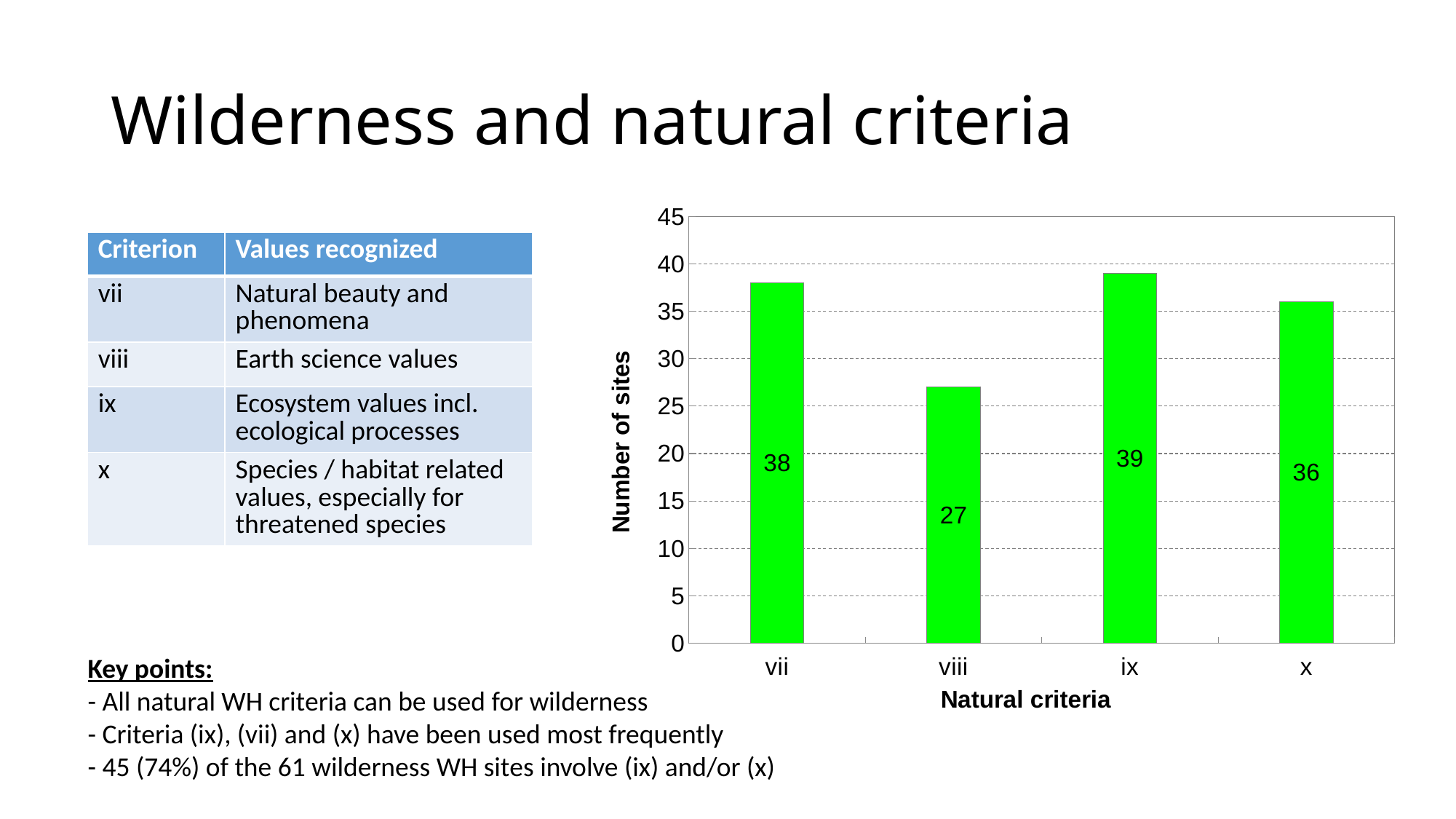
What type of chart is shown on the slide? bar chart How many natural criteria are shown on the x axis of the chart? 4 What is the difference in number of sites between criterion ix and criterion viii? 12 What is the number of sites for criterion ix? 39 Which natural criterion has the lowest number of sites? viii Is the number of sites for criterion viii greater or less than 30? less What is the label of the vertical axis of the chart? Number of sites Which has more sites, criterion vii or criterion x? vii Which natural criterion has the highest number of sites? ix What is the number of sites for criterion viii? 27 What is the number of sites for criterion vii? 38 What is the number of sites for criterion x? 36